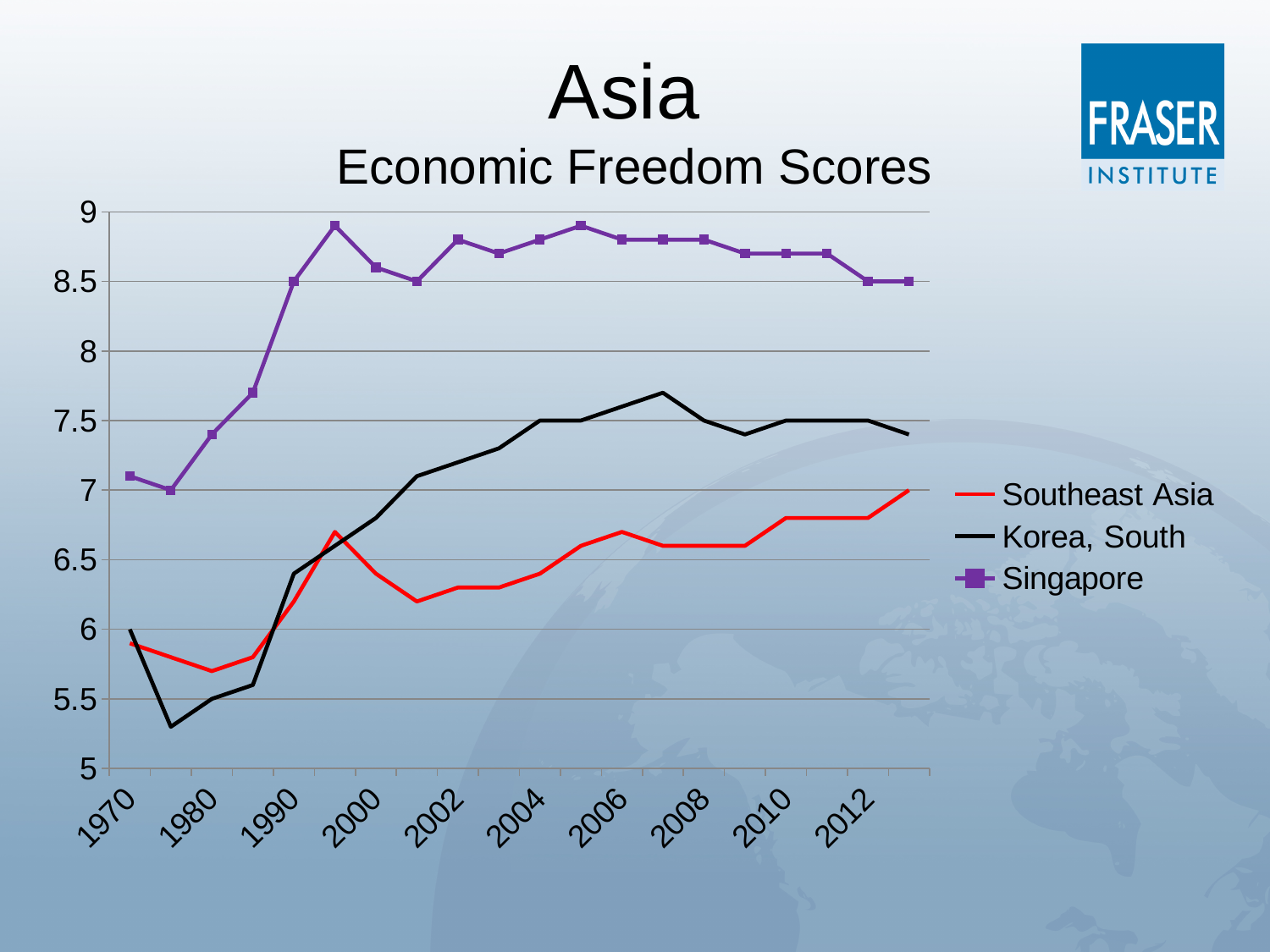
In 2010, which is higher: Korea, South or Southeast Asia? Korea, South Which series has the highest economic freedom scores across the whole period? Singapore How many series does the legend list? 3 Is the value for Korea, South in 1975 greater or less than 5.5? less What is Singapore's score in 2012? 8.5 Is the value for Southeast Asia in 2002 greater or less than 6.5? less What kind of chart is shown on the slide? line chart Which series is drawn with square markers? Singapore Is the value for Southeast Asia in 2010 greater or less than 6.5? greater Which series has the lowest score in 1975? Korea, South Does Singapore's score rise or fall between 1970 and 1990? rise